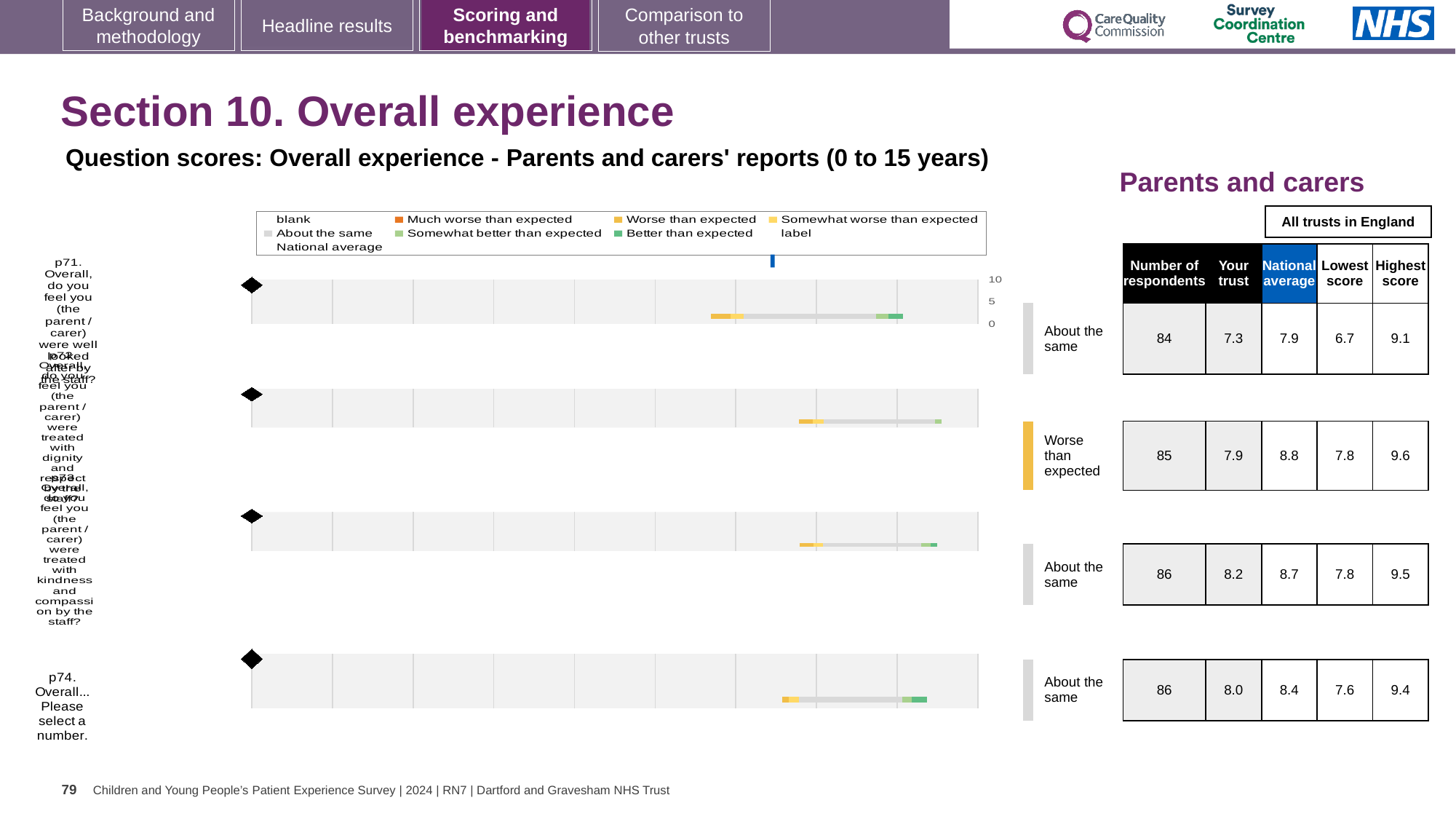
How many questions (categories) are plotted in the chart? 4 What is the 'Your trust' score for p71 (Overall, do you feel you were well looked after by the staff?)? 7.3 Which question has the lowest 'Your trust' score? p71 What is the national average score for p72 (treated with dignity and respect)? 8.8 What is the highest score across all trusts in England for p73 (treated with kindness and compassion)? 9.5 Which legend entry is shown in orange in the chart legend? Much worse than expected What kind of chart is used to show the question scores on this slide? bar chart How many entries does the chart legend list? 9 How many respondents answered p74 (Overall... Please select a number)? 86 What is the difference between the national average and the 'Your trust' score for p72? 0.9 What is the title of the chart on this slide? Question scores: Overall experience - Parents and carers' reports (0 to 15 years) Which question is rated 'Worse than expected' compared with other trusts? p72